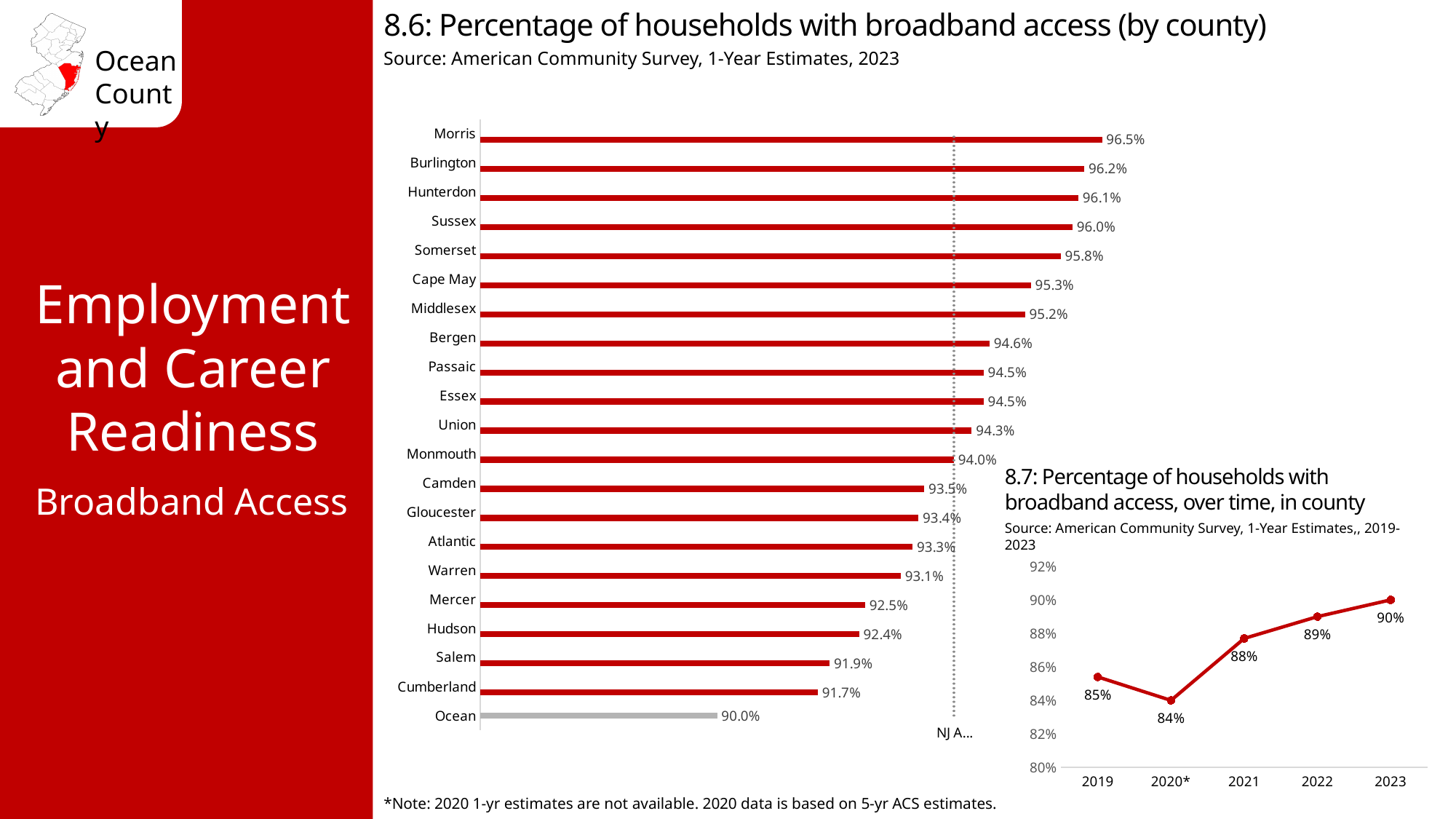
In chart 8.7, which year has the lowest value? 2020* In chart 8.6, which has a higher value, Bergen or Camden? Bergen In chart 8.6, what is the value shown for Cape May? 95.3% In chart 8.6, how many counties are shown? 21 What kind of chart is chart 8.6? Bar chart In chart 8.6, what is the difference between Morris and Ocean? 6.5 percentage points In chart 8.6, which county has the highest percentage of households with broadband access? Morris In chart 8.6, which county has the lowest percentage of households with broadband access? Ocean In chart 8.6, what percentage of households in Ocean County have broadband access? 90.0% In chart 8.7, do values rise or fall from 2020 to 2023? Rise In chart 8.7, what was the percentage of households with broadband access in 2021? 88% In chart 8.7, what is the difference between the 2023 and 2019 values? 5 percentage points